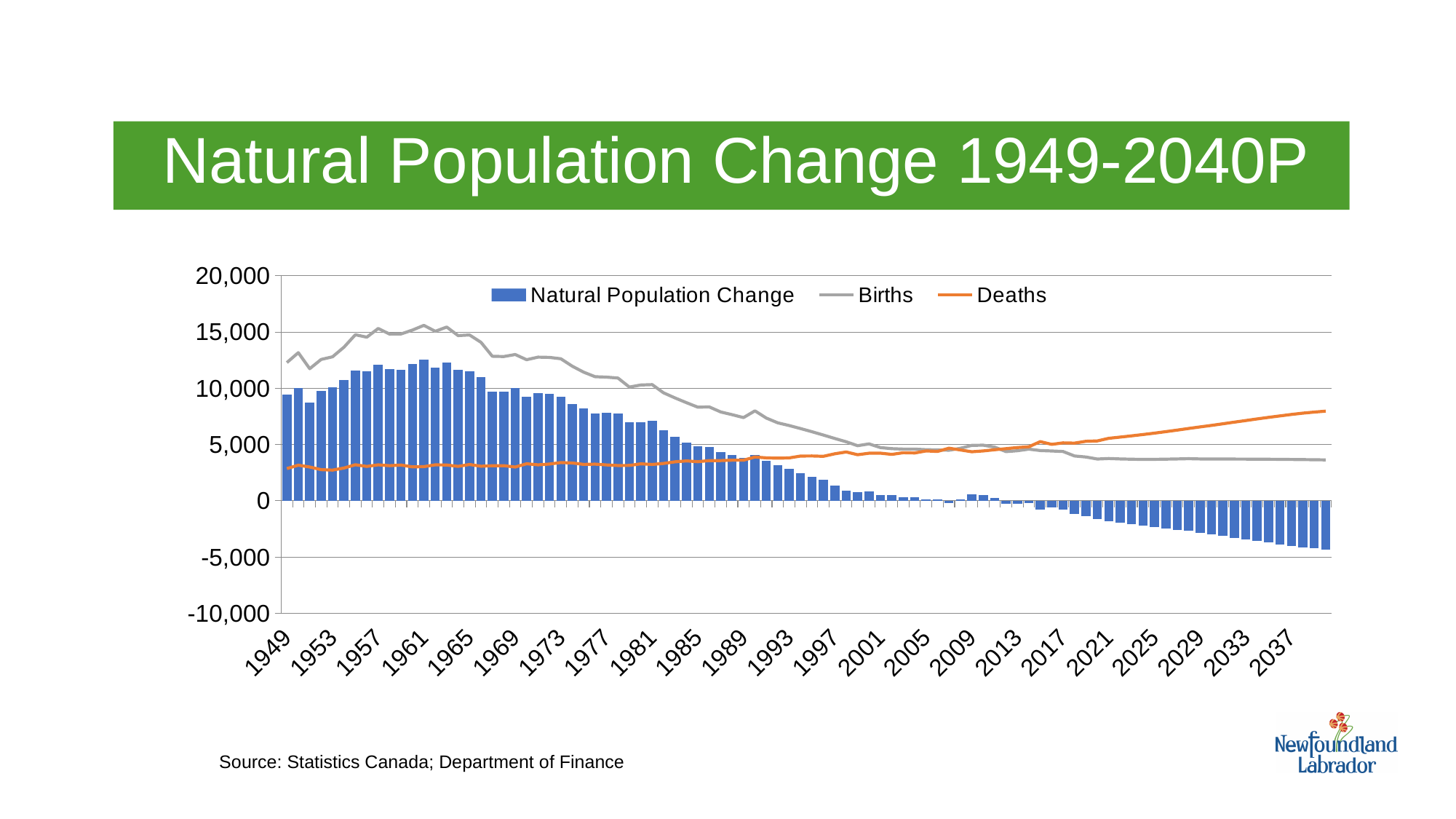
What kind of chart is this? Combined bar and line chart In 1949, which is larger: Births or Deaths? Births Do the Natural Population Change bars rise or fall from 1961 to 2037? fall Is the value for Births in 2037 greater or less than 5,000? less Is the value for Deaths in 1949 greater or less than 5,000? less Is the Natural Population Change bar for 2037 greater or less than 0? less What is the title of the chart? Natural Population Change 1949-2040P Does the Deaths line rise or fall from 1949 to the end of the chart? rise How many series does the legend list? 3 What colour is the Deaths line? Orange